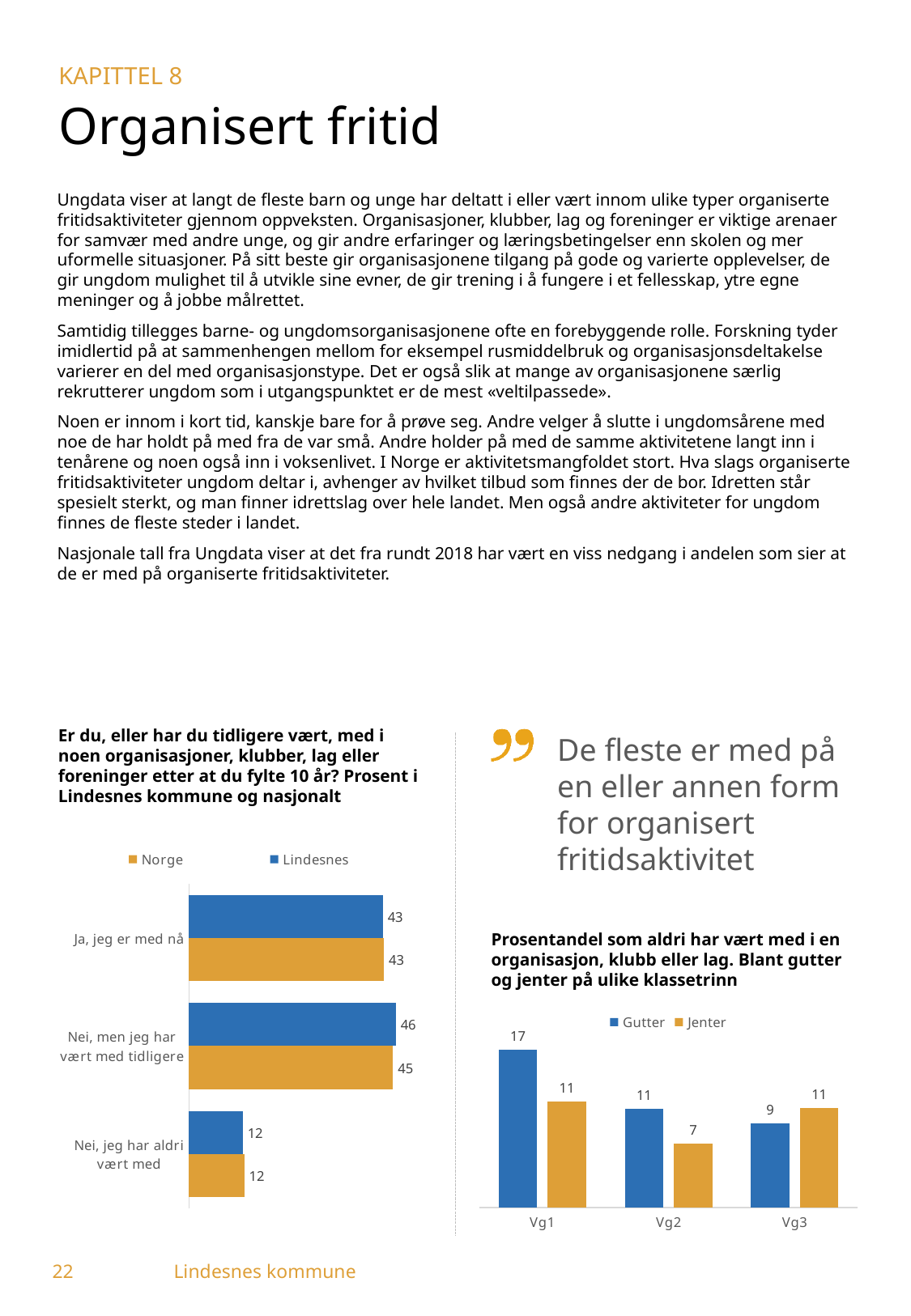
In the right chart (Prosentandel som aldri har vært med i en organisasjon...), how many class levels are shown on the x axis? 3 What kind of chart is the left chart (Er du, eller har du tidligere vært, med i noen organisasjoner...)? Bar chart In the left chart (Er du, eller har du tidligere vært, med i noen organisasjoner...), what is the difference between Lindesnes and Norge for 'Nei, men jeg har vært med tidligere'? 1 In the right chart (Prosentandel som aldri har vært med i en organisasjon...), what is the value for Gutter at Vg1? 17 In the left chart (Er du, eller har du tidligere vært, med i noen organisasjoner...), what is the value for Norge for 'Ja, jeg er med nå'? 43 In the right chart (Prosentandel som aldri har vært med i en organisasjon...), which class level has the highest value for Gutter? Vg1 In the right chart (Prosentandel som aldri har vært med i en organisasjon...), is the value for Gutter or Jenter larger at Vg3? Jenter In the right chart (Prosentandel som aldri har vært med i en organisasjon...), what is the difference between Gutter and Jenter at Vg1? 6 In the right chart (Prosentandel som aldri har vært med i en organisasjon...), what is the value for Jenter at Vg2? 7 In the left chart (Er du, eller har du tidligere vært, med i noen organisasjoner...), how many series does the legend list? 2 In the left chart (Er du, eller har du tidligere vært, med i noen organisasjoner...), what is the value for Lindesnes for 'Nei, men jeg har vært med tidligere'? 46 In the left chart (Er du, eller har du tidligere vært, med i noen organisasjoner...), which category has the lowest value for Lindesnes? Nei, jeg har aldri vært med